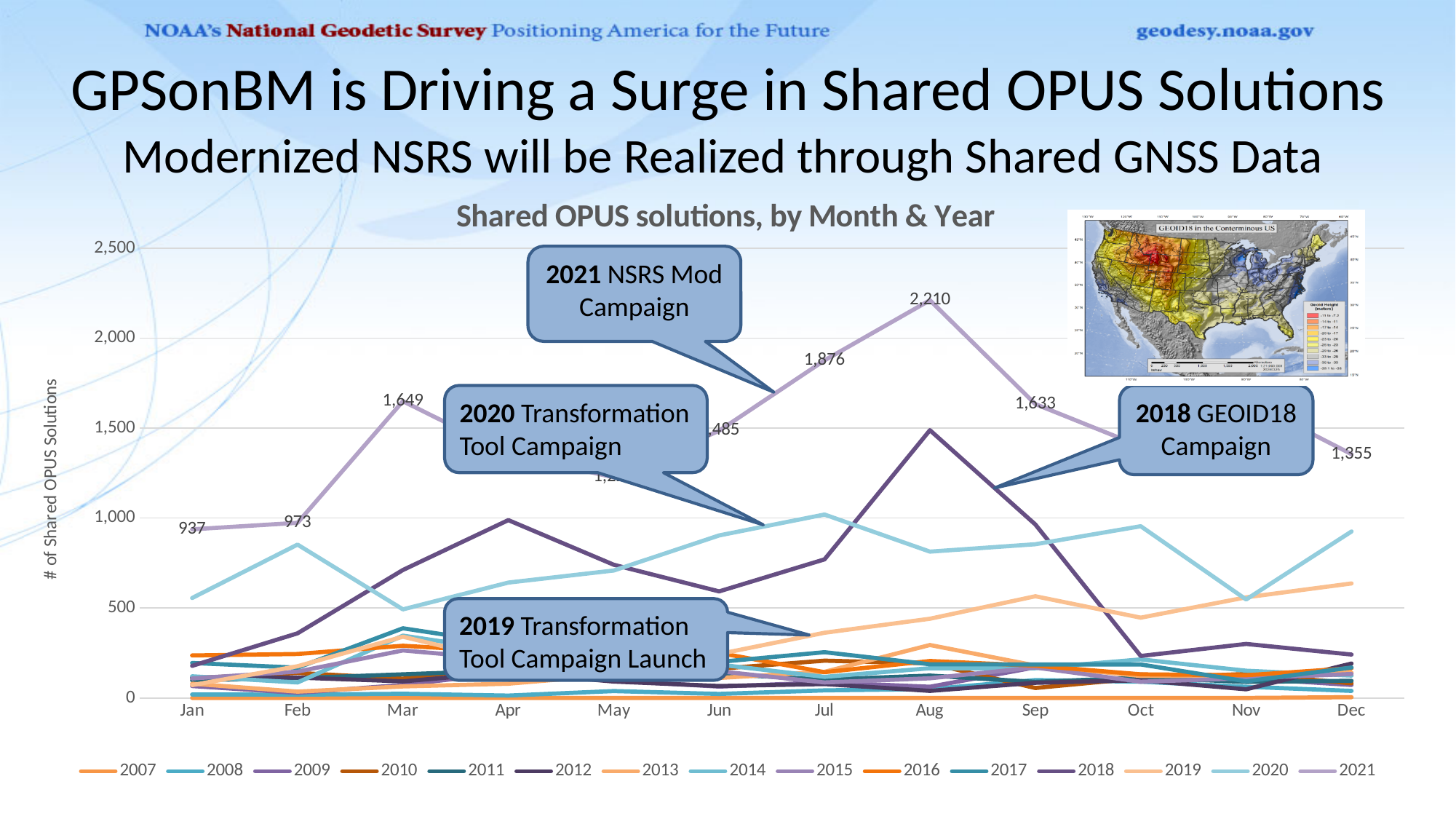
Is the value for 2018 in October greater or less than 500? less In which month does the 2021 series reach its highest value? Aug What is the value for 2021 in March? 1,649 What is the value for 2021 in August? 2,210 What is the difference between the 2021 values for August and July? 334 What is the value for 2021 in January? 937 What is the title of the chart? Shared OPUS solutions, by Month & Year How many months are shown along the x axis of the chart? 12 Which is larger for 2021: the September value or the December value? September What kind of chart is shown on the slide? line chart How many series does the chart legend list? 15 Is the value for 2018 in August greater or less than 1,000? greater